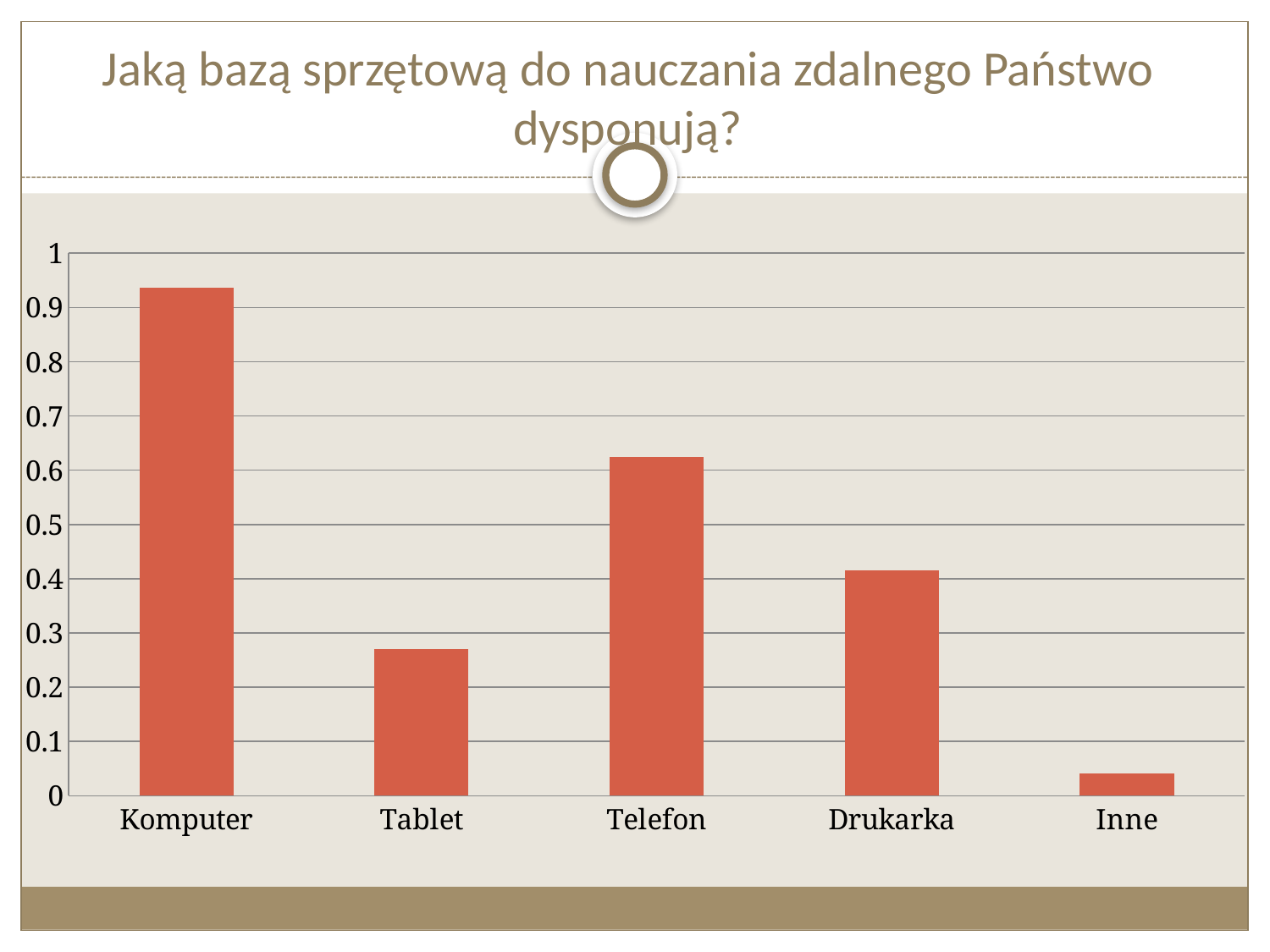
Is the value for Inne greater or less than 0.1? less Which is larger, the value for Tablet or the value for Inne? Tablet Is the value for Komputer greater or less than 0.9? greater Which is larger, the value for Telefon or the value for Drukarka? Telefon Is the value for Tablet greater or less than 0.3? less Which category has the highest value? Komputer What kind of chart is shown on the slide? bar chart What is the title of the slide containing the chart? Jaką bazą sprzętową do nauczania zdalnego Państwo dysponują? How many categories are shown on the x axis? 5 Which category has the lowest value? Inne